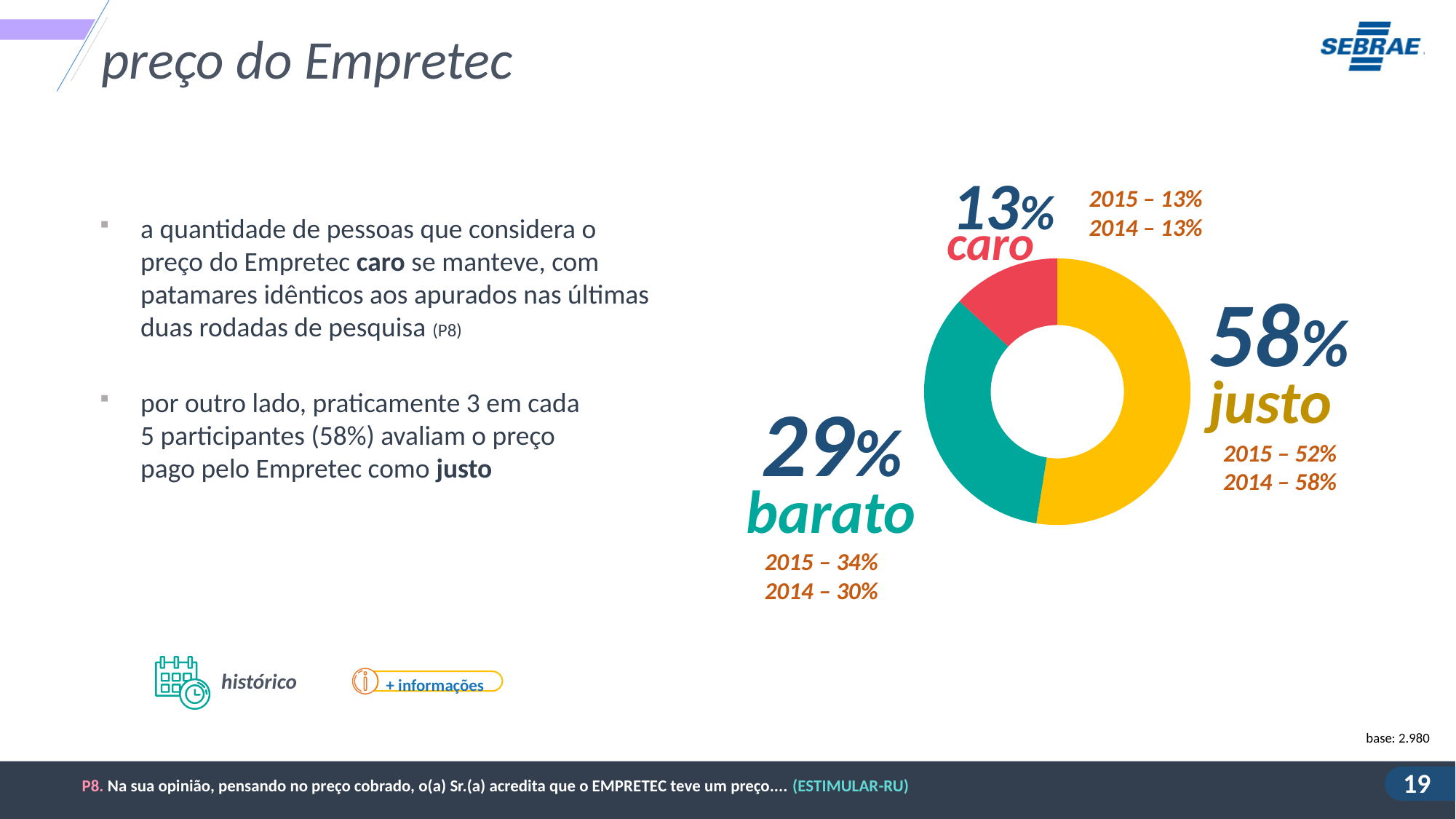
Which slice is larger, "barato" or "caro"? barato Which category has the largest slice of the donut chart? justo Which category has the smallest slice of the donut chart? caro What was the share for "justo" in 2015, according to the historical values next to the chart? 52% What kind of chart is shown on the slide? donut (pie) chart What share of respondents consider the Empretec price "caro"? 13% What is the difference in percentage points between the "justo" and "barato" slices? 29 What share of respondents consider the Empretec price "justo"? 58% What colour is the "barato" slice of the donut chart? teal (green) How many categories does the donut chart show? 3 What was the share for "barato" in 2014, according to the historical values next to the chart? 30% What share of respondents consider the Empretec price "barato"? 29%